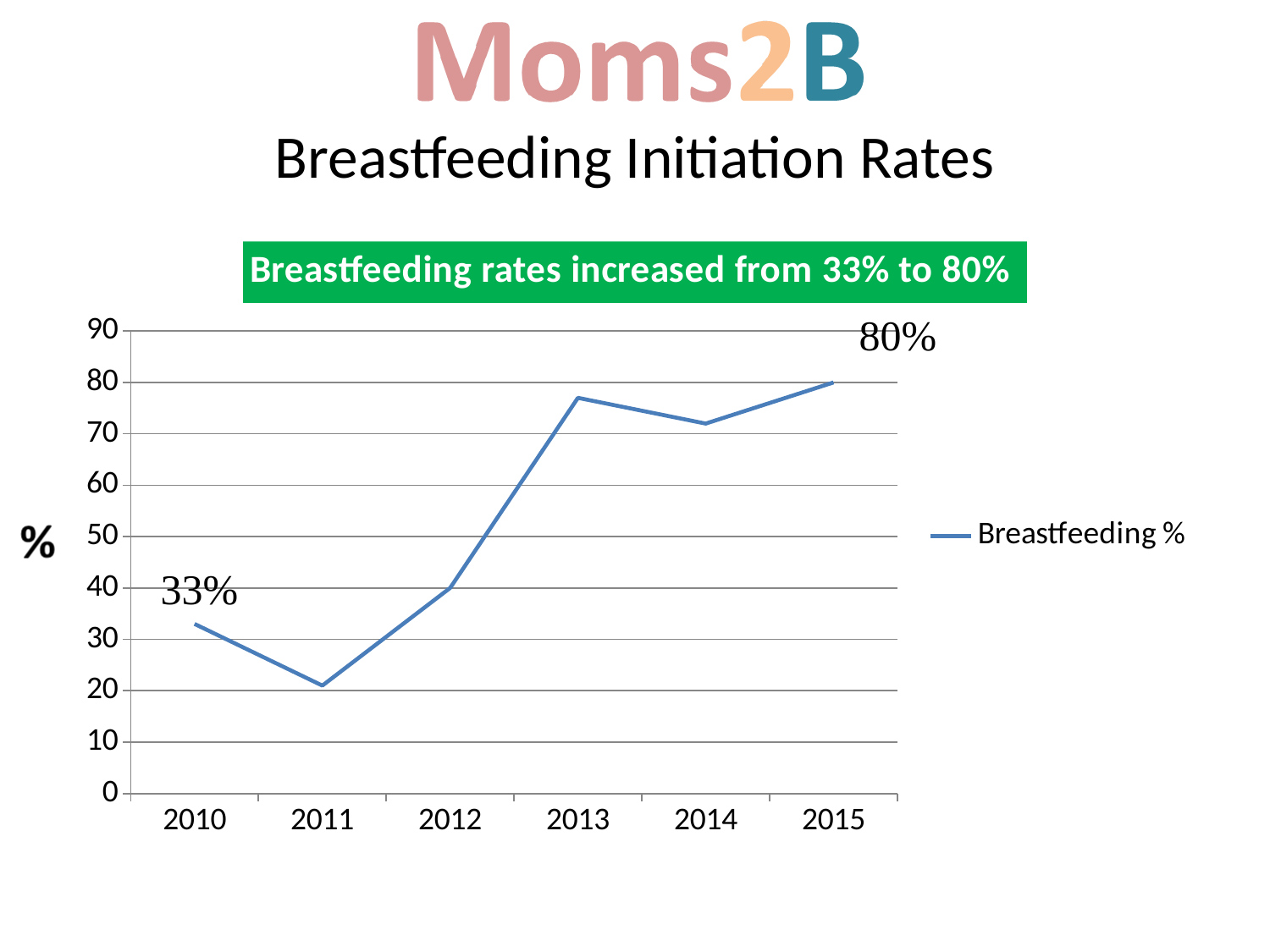
Is the value for 2014 greater or less than 60? greater Which year has the higher breastfeeding rate, 2013 or 2014? 2013 What kind of chart is shown on the slide? Line chart What is the breastfeeding initiation rate shown for 2010? 33% Is the value for 2011 greater or less than 30? less Is the value for 2013 greater or less than 70? greater By how many percentage points did the breastfeeding rate increase from 2010 to 2015? 47 How many series does the legend list? 1 How many years are plotted on the x axis? 6 Which year has the lowest breastfeeding rate? 2011 Which year has the highest breastfeeding rate? 2015 What is the breastfeeding initiation rate shown for 2015? 80%